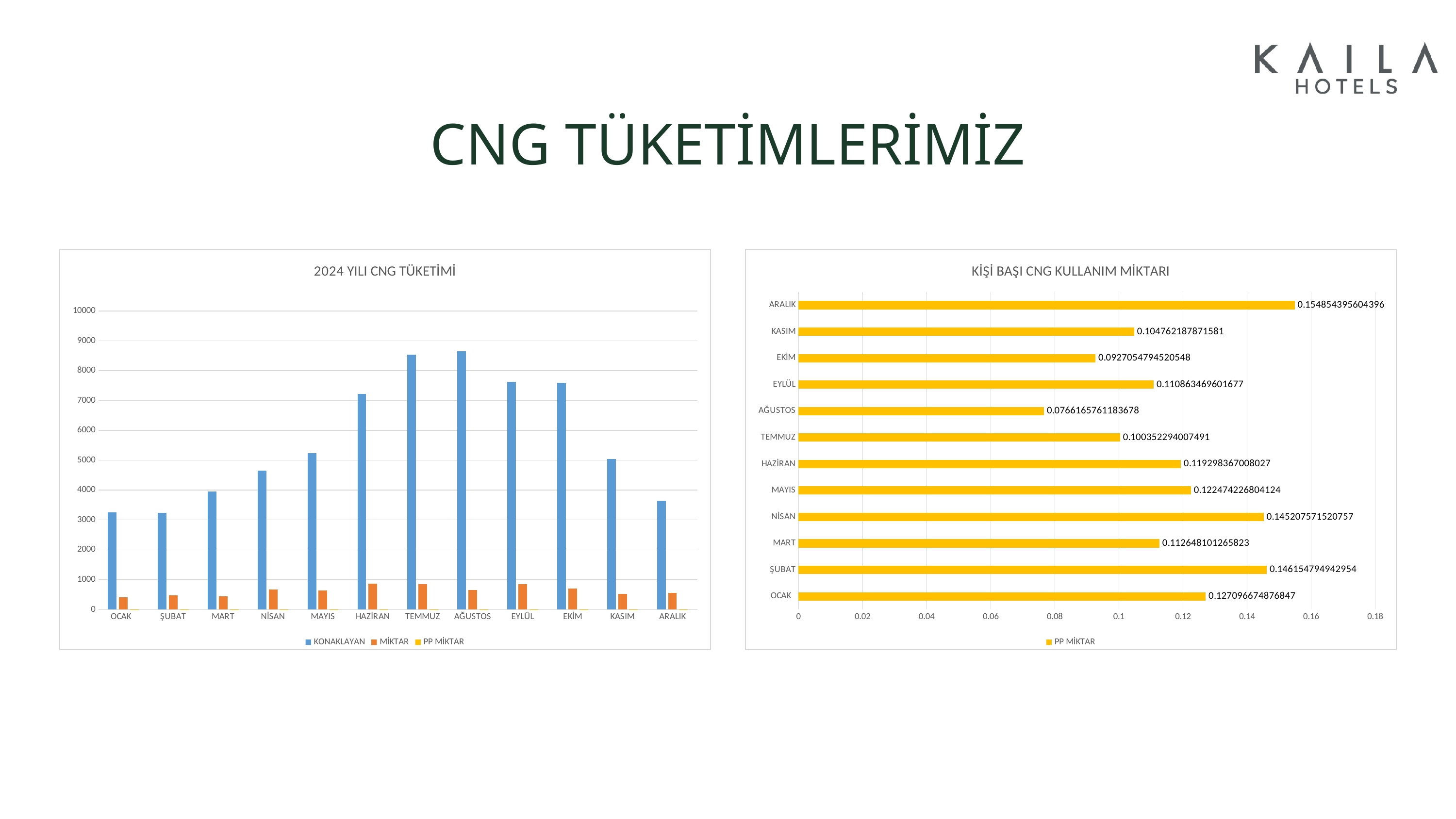
In the "2024 YILI CNG TÜKETİMİ" chart, is the KONAKLAYAN value for HAZİRAN greater or less than 7000? greater In the "KİŞİ BAŞI CNG KULLANIM MİKTARI" chart, what is the value for AĞUSTOS? 0.0766165761183678 In the "2024 YILI CNG TÜKETİMİ" chart, is the MİKTAR value for HAZİRAN greater or less than 1000? less How many months are shown on the x axis of the "2024 YILI CNG TÜKETİMİ" chart? 12 How many series does the legend of the "2024 YILI CNG TÜKETİMİ" chart list? 3 What series name is shown in the legend of the "KİŞİ BAŞI CNG KULLANIM MİKTARI" chart? PP MİKTAR In the "KİŞİ BAŞI CNG KULLANIM MİKTARI" chart, which month has the highest value? ARALIK In the "2024 YILI CNG TÜKETİMİ" chart, is the KONAKLAYAN value for ARALIK greater or less than 4000? less In the "KİŞİ BAŞI CNG KULLANIM MİKTARI" chart, what is the value for ARALIK? 0.154854395604396 In the "2024 YILI CNG TÜKETİMİ" chart, which is larger, the KONAKLAYAN value for MAYIS or for MART? MAYIS What type of chart is the "2024 YILI CNG TÜKETİMİ" chart? bar chart In the "KİŞİ BAŞI CNG KULLANIM MİKTARI" chart, which month has the lowest value? AĞUSTOS